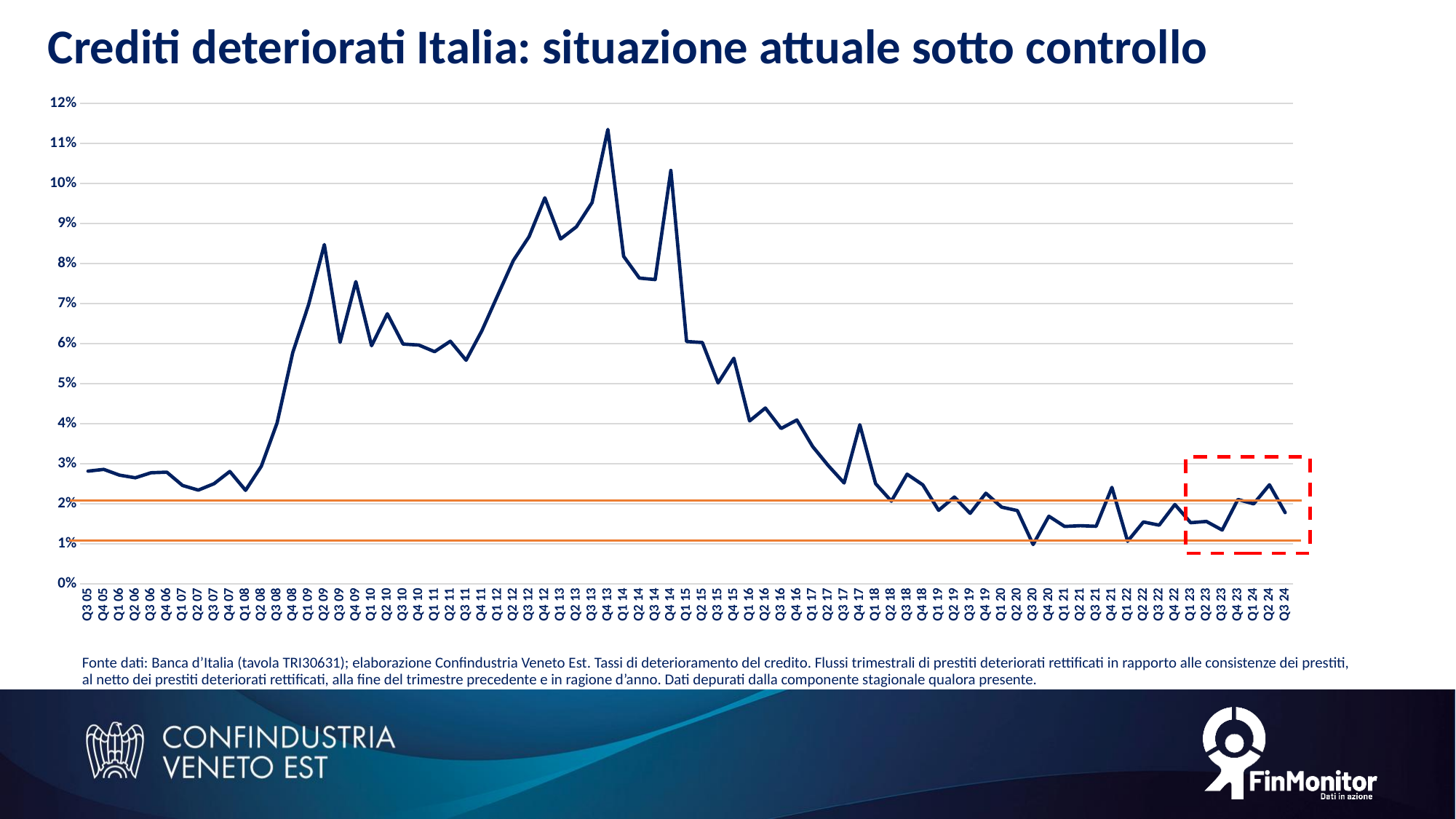
Is the value for Q3 05 greater or less than 2%? greater Is the value for Q2 09 greater or less than 8%? greater Does the line rise or fall between Q4 13 and Q3 20? fall Is the value for Q3 24 greater or less than 2%? less What kind of chart is shown on the slide? line chart At which two percentage levels are the horizontal orange reference lines drawn? 2% and 1% What is the title of the chart on the slide? Crediti deteriorati Italia: situazione attuale sotto controllo In which quarter does the line reach its highest value? Q4 13 Which is larger, the value for Q4 13 or the value for Q4 14? Q4 13 Which is larger, the value for Q2 09 or the value for Q4 09? Q2 09